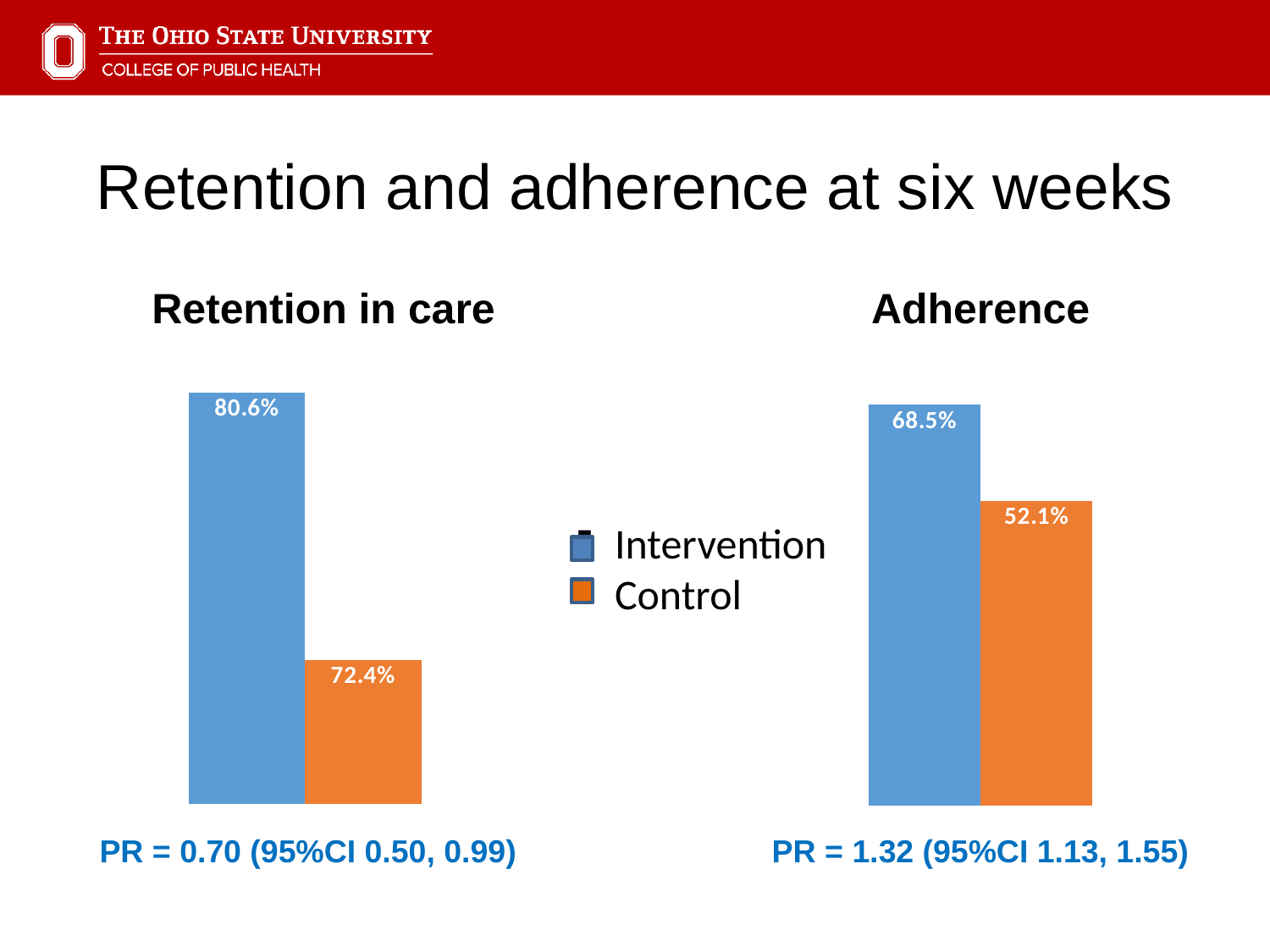
What kind of chart is the Adherence chart? bar chart Which colour represents the Control group in the charts? orange In the Retention in care chart, what is the value for Intervention? 80.6% In the Adherence chart, which group has the lower value? Control In the Adherence chart, what is the difference between the Intervention and Control values? 16.4 percentage points In the Retention in care chart, what is the value for Control? 72.4% In the Retention in care chart, what is the difference between the Intervention and Control values? 8.2 percentage points Is the Intervention value in the Retention in care chart larger or smaller than the Intervention value in the Adherence chart? larger In the Retention in care chart, which group has the higher value? Intervention How many series does the legend list? 2 In the Adherence chart, what is the value for Intervention? 68.5% In the Adherence chart, what is the value for Control? 52.1%